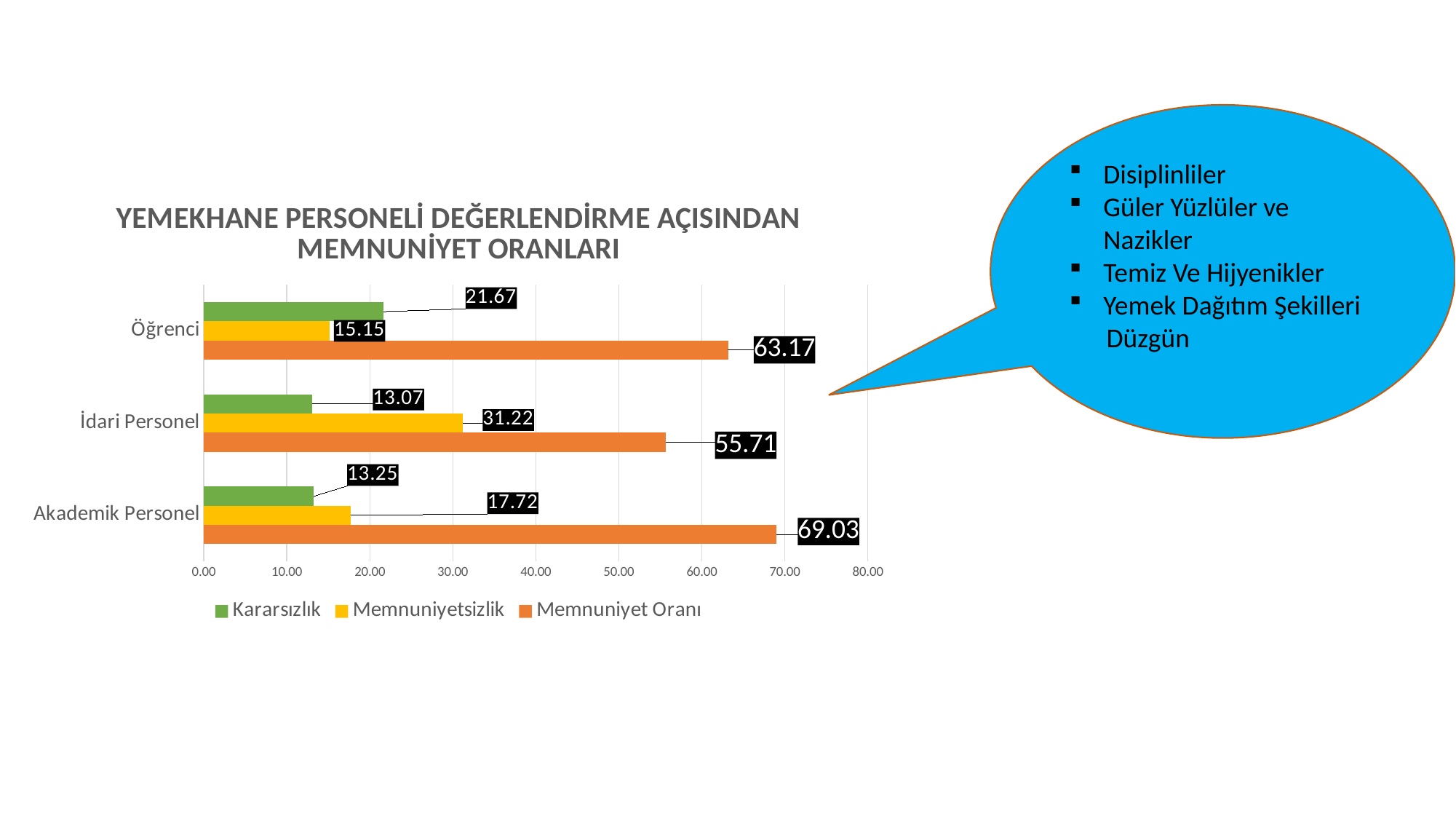
Is the Memnuniyet Oranı for İdari Personel greater or less than 60.00? less What is the difference between the Memnuniyet Oranı for Akademik Personel and İdari Personel? 13.32 What is the Memnuniyet Oranı value for Öğrenci? 63.17 How many series does the legend list? 3 Which is larger: the Kararsızlık value for Öğrenci or for İdari Personel? Öğrenci How many categories are shown on the chart? 3 Which category has the lowest Memnuniyetsizlik value? Öğrenci What is the Kararsızlık value for Akademik Personel? 13.25 Which category has the highest Memnuniyet Oranı? Akademik Personel What is the Memnuniyetsizlik value for İdari Personel? 31.22 What kind of chart is shown on the slide? Bar chart Which series is shown in orange in the legend? Memnuniyet Oranı